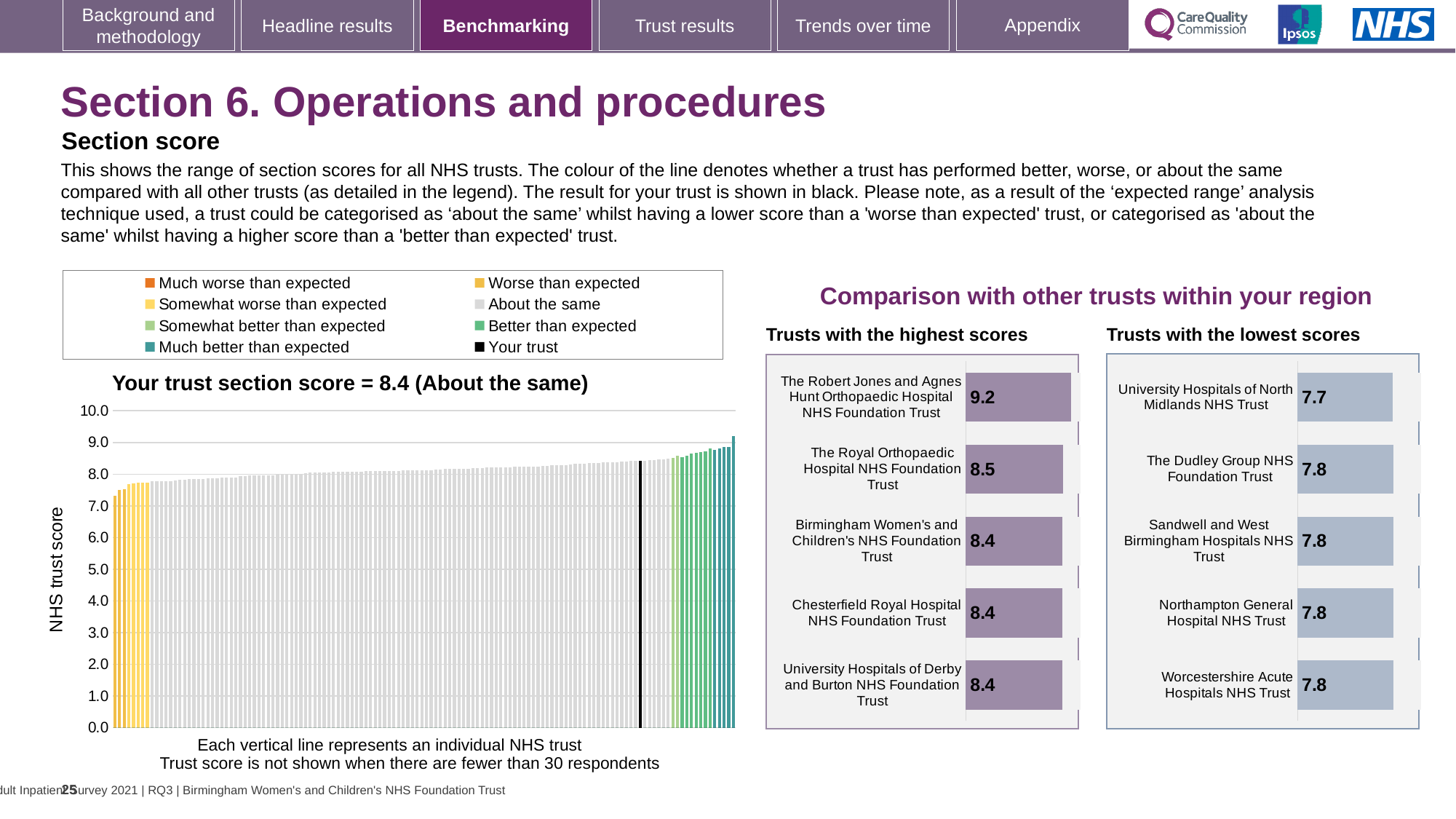
In the 'Trusts with the lowest scores' chart, which trust has the lowest score? University Hospitals of North Midlands NHS Trust In the 'Trusts with the highest scores' chart, what is the difference between the scores of The Robert Jones and Agnes Hunt Orthopaedic Hospital NHS Foundation Trust and The Royal Orthopaedic Hospital NHS Foundation Trust? 0.7 In the 'Trusts with the highest scores' chart, what is the score for The Royal Orthopaedic Hospital NHS Foundation Trust? 8.5 In the 'Trusts with the highest scores' chart, what is the score for The Robert Jones and Agnes Hunt Orthopaedic Hospital NHS Foundation Trust? 9.2 What type of chart is the 'Your trust section score' chart on the left? Bar chart In the 'Trusts with the lowest scores' chart, what is the score for University Hospitals of North Midlands NHS Trust? 7.7 In the 'Trusts with the highest scores' chart, which trust has the highest score? The Robert Jones and Agnes Hunt Orthopaedic Hospital NHS Foundation Trust In the 'Your trust section score' chart, do the bar values rise or fall from left to right? Rise In the 'Trusts with the lowest scores' chart, which has the larger score: University Hospitals of North Midlands NHS Trust or The Dudley Group NHS Foundation Trust? The Dudley Group NHS Foundation Trust How many trusts are listed in the 'Trusts with the lowest scores' chart? 5 In the 'Your trust section score' chart, is the value of the leftmost bar greater or less than 7.0? greater What is the y-axis label of the 'Your trust section score' chart? NHS trust score